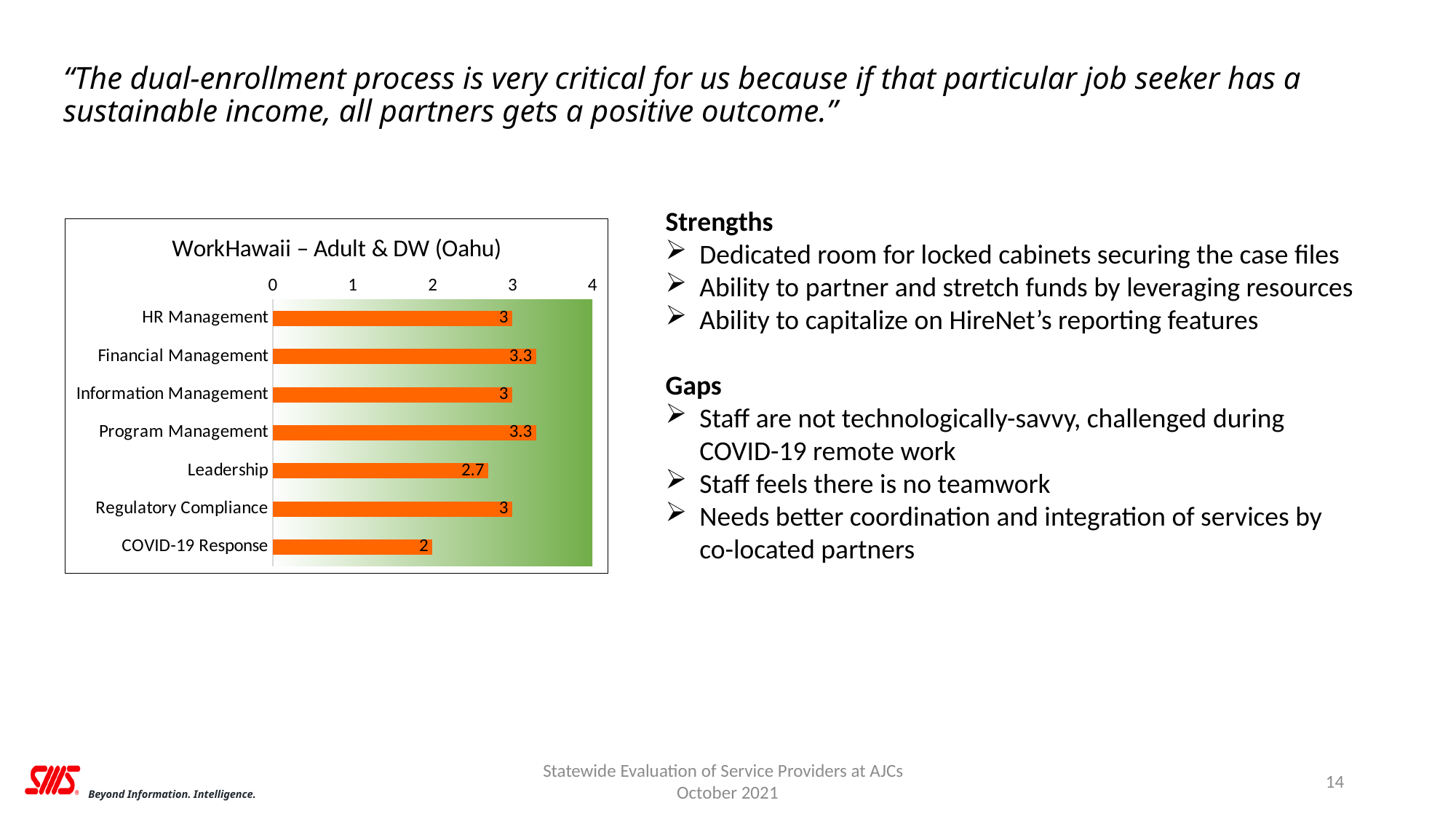
What is the value for Leadership? 2.7 What is the value for COVID-19 Response? 2 What is the difference between the values for HR Management and COVID-19 Response? 1 What is the value for Financial Management? 3.3 What is the value for Regulatory Compliance? 3 Is the value for Leadership greater or less than 3? less Which category has the lowest value? COVID-19 Response What kind of chart is shown on the slide? bar chart What is the difference between the values for Program Management and Leadership? 0.6 Which is larger, the value for Financial Management or the value for Information Management? Financial Management What is the title of the chart? WorkHawaii – Adult & DW (Oahu) How many categories are shown in the chart? 7